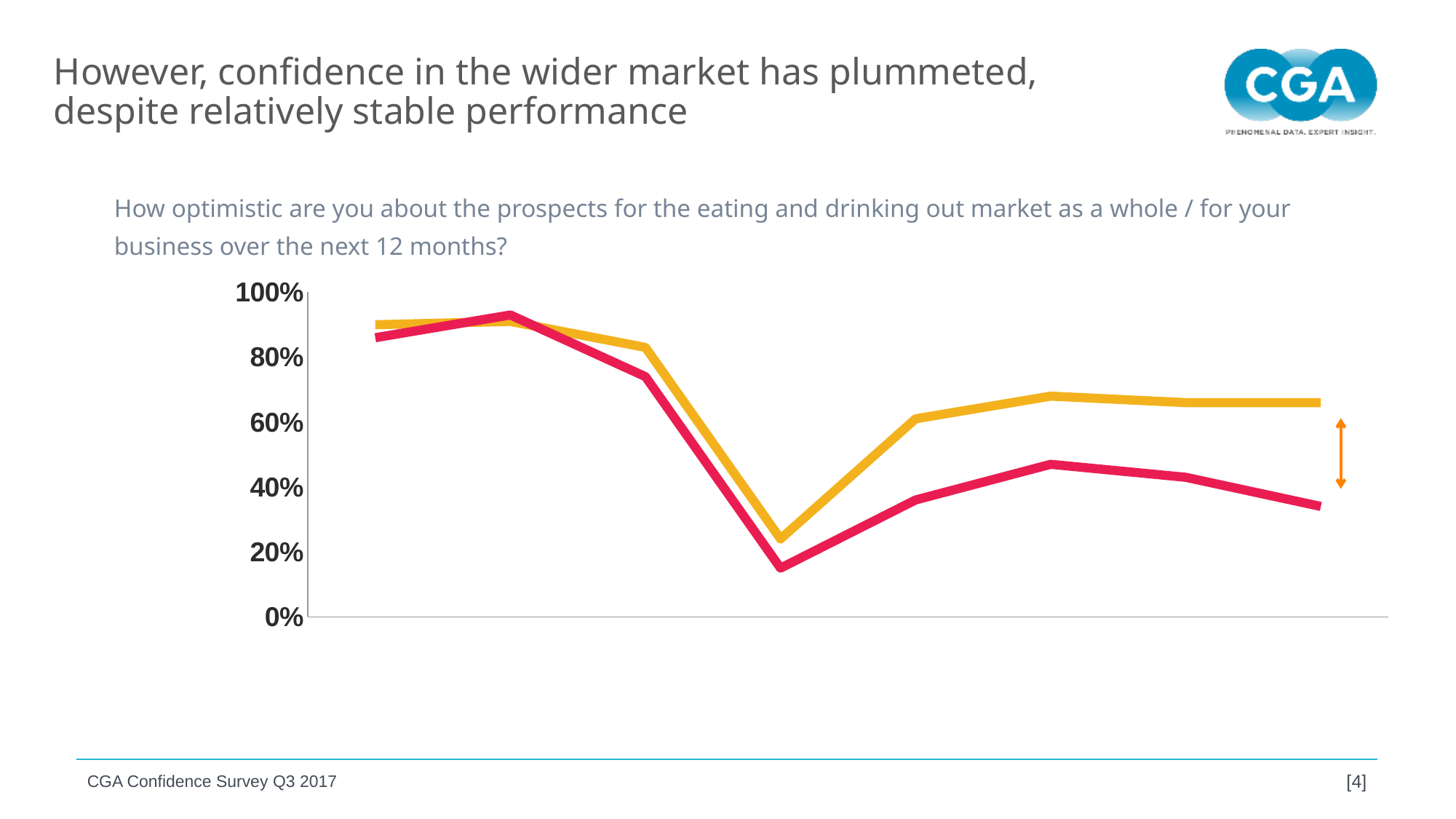
At which point along the x axis (counting from the left) does the red line reach its lowest value? the 4th point What is the highest value shown on the chart's vertical axis? 100% Is the first (leftmost) value of the yellow line greater or less than 80%? greater What kind of chart is shown on the slide? line chart At the rightmost point of the chart, which line is higher, the yellow line or the red line? the yellow line How many data points does each line on the chart have? 8 How many lines are plotted on the chart? 2 Is the lowest point of the yellow line greater or less than 40%? less Is the last (rightmost) value of the yellow line greater or less than 60%? greater Comparing the first and last points, do the values of the red line rise or fall across the chart? fall